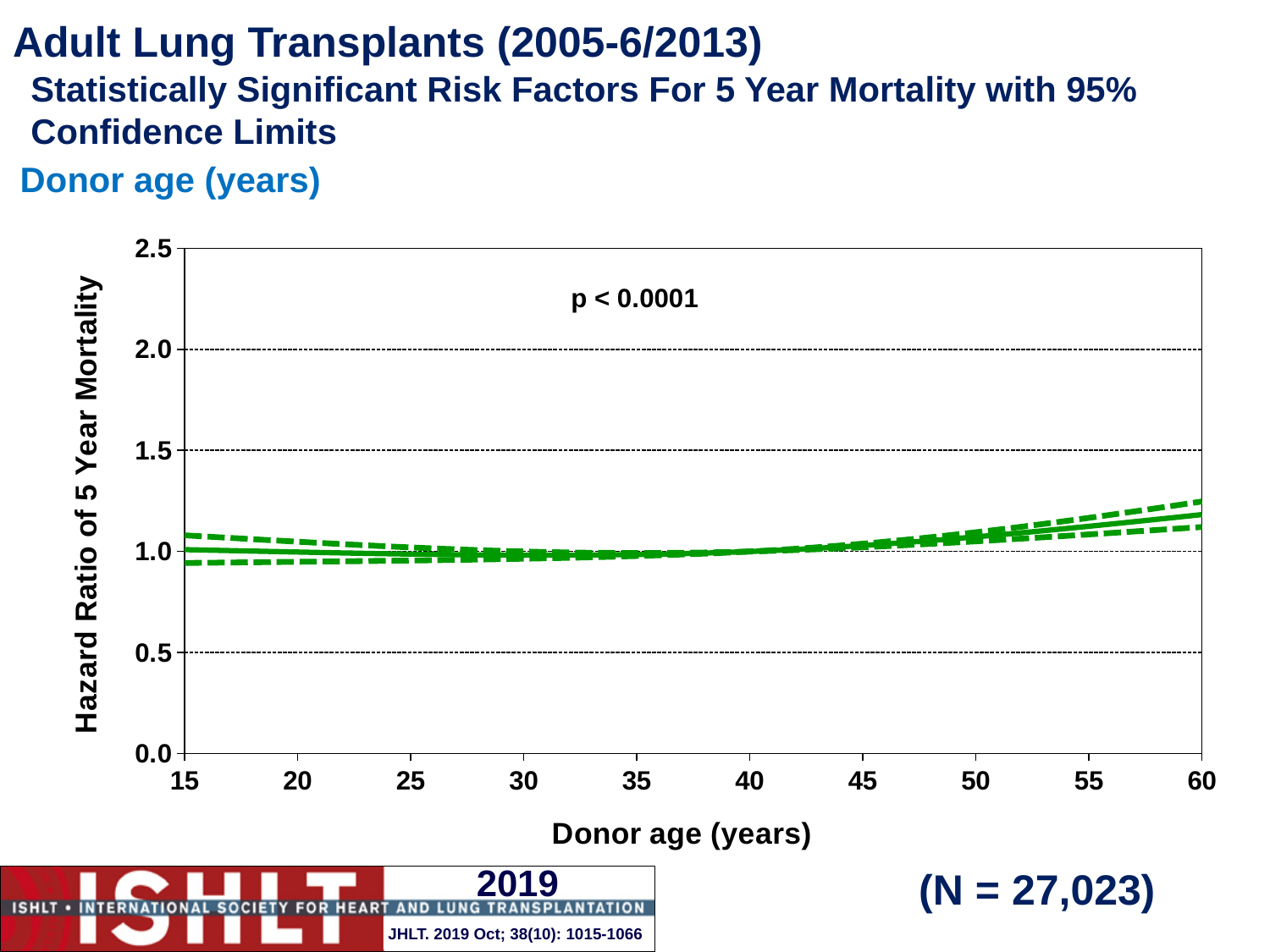
What is the label of the y axis? Hazard Ratio of 5 Year Mortality Is the hazard ratio at a donor age of 60 years larger or smaller than at a donor age of 40 years? larger How many lines (solid and dashed) are plotted on the chart? 3 What is the label of the x axis? Donor age (years) At which donor age shown on the x axis is the hazard ratio highest? 60 Is the hazard ratio for a donor age of 60 years greater or less than 1.0? greater Is the hazard ratio for a donor age of 15 years greater or less than 1.5? less What sample size (N) is shown on the slide? N = 27,023 What kind of chart is shown on the slide? line chart What p-value is printed on the chart? p < 0.0001 Does the hazard ratio rise or fall as donor age increases from 40 to 60 years? rise Is the hazard ratio for a donor age of 60 years greater or less than 1.5? less